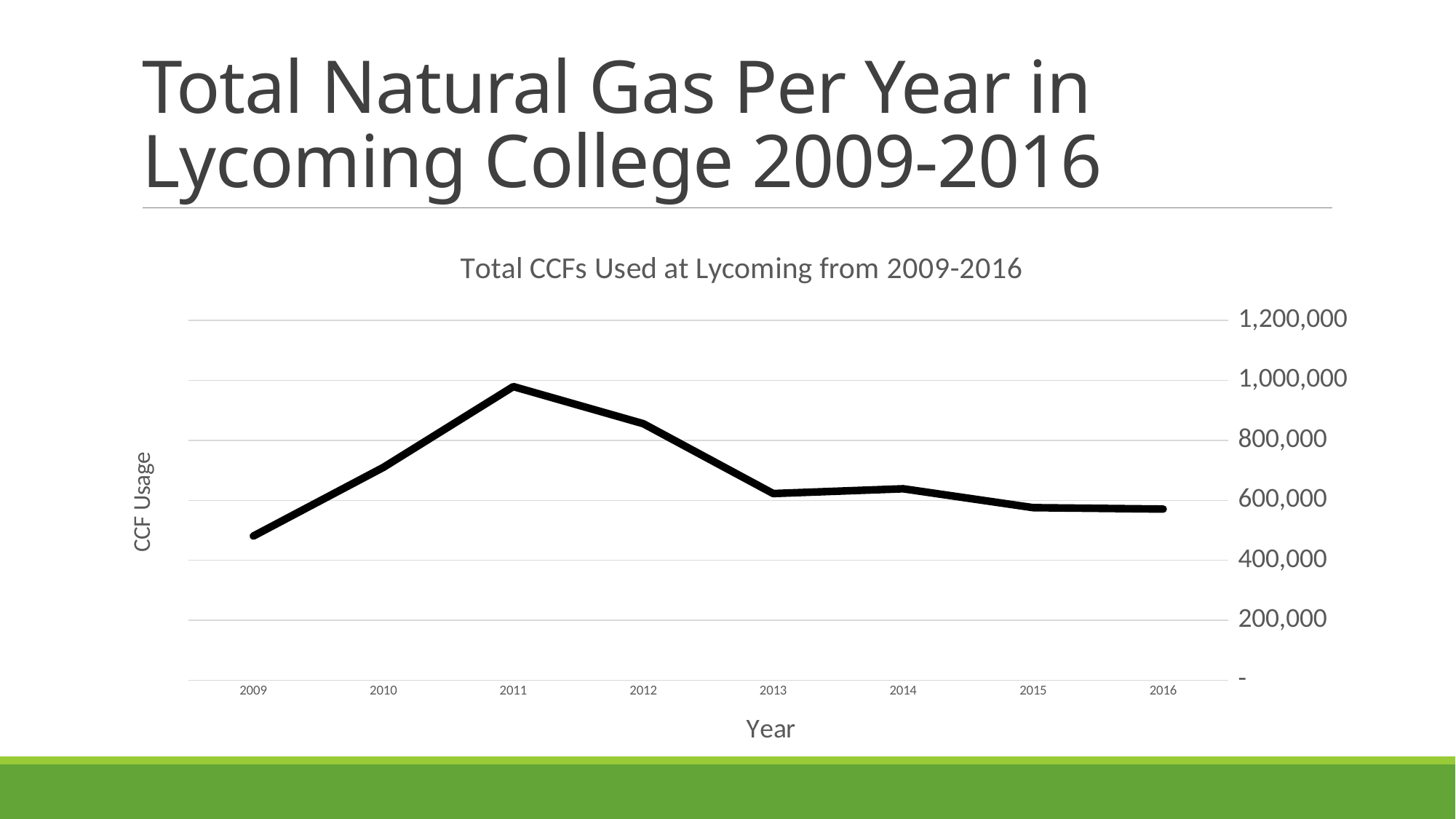
Is the value for 2009 greater or less than 600,000? less What is the title of the chart? Total CCFs Used at Lycoming from 2009-2016 Is the value for 2010 greater or less than 600,000? greater Is the value for 2016 greater or less than 800,000? less Do the values rise or fall from 2011 to 2013? fall How many years are plotted on the x axis of the chart? 8 Which year has the highest CCF usage? 2011 Which year has the lowest CCF usage? 2009 Which year has the larger CCF usage, 2010 or 2012? 2012 What kind of chart is shown on the slide? line chart Do the values rise or fall from 2009 to 2011? rise